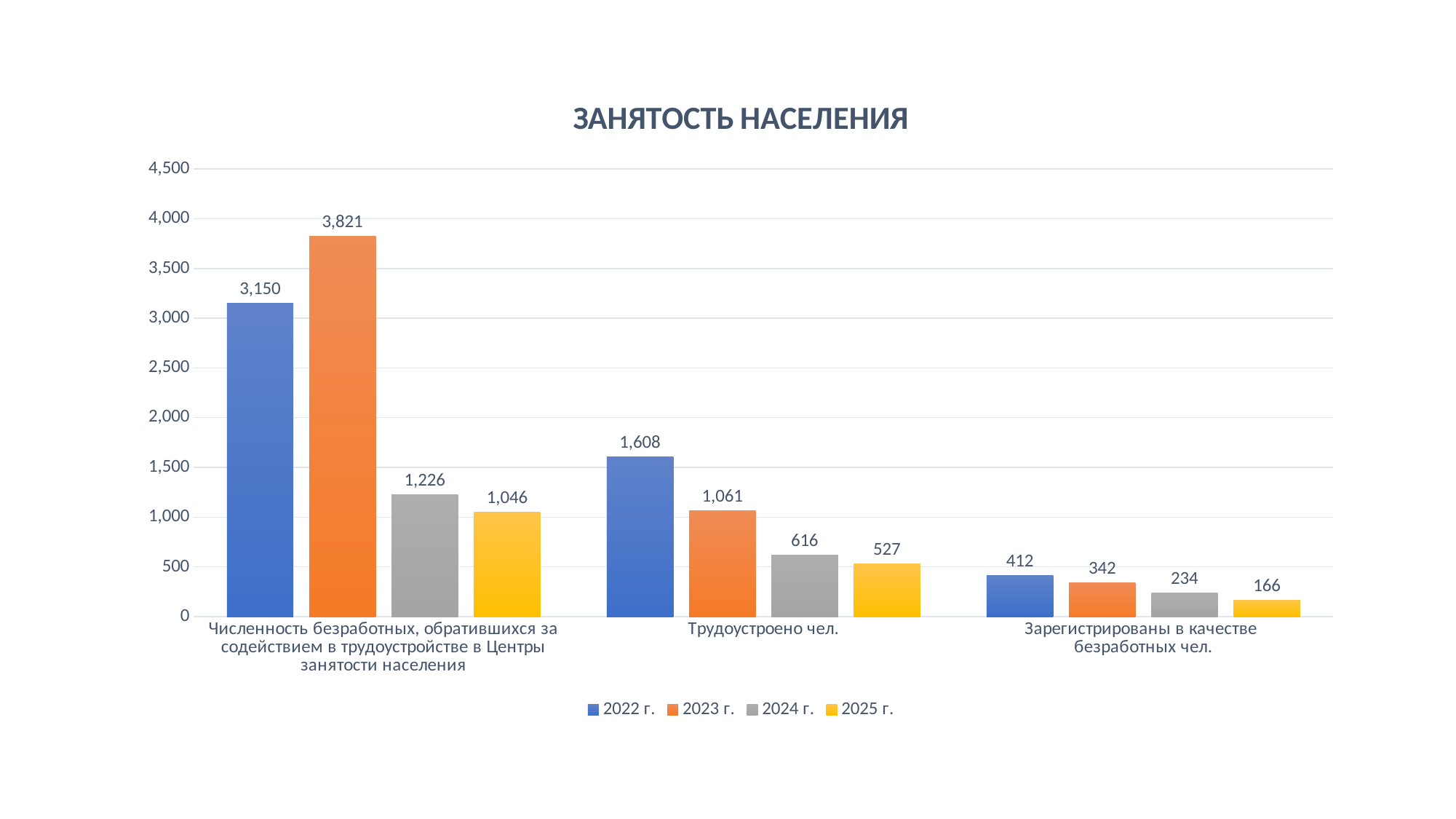
Which year has the lowest value in the category 'Численность безработных, обратившихся за содействием в трудоустройстве в Центры занятости населения'? 2025 г. Which year has the highest value in the category 'Трудоустроено чел.'? 2022 г. How many series does the legend list? 4 What is the value for 2025 г. in the category 'Зарегистрированы в качестве безработных чел.'? 166 Which is larger in the category 'Трудоустроено чел.': the value for 2023 г. or the value for 2024 г.? 2023 г. What kind of chart is shown on the slide? bar chart What is the title of the chart? ЗАНЯТОСТЬ НАСЕЛЕНИЯ Is the value for 2022 г. in the category 'Трудоустроено чел.' greater or less than 1,500? greater What is the difference between the 2022 г. and 2023 г. values in the category 'Зарегистрированы в качестве безработных чел.'? 70 How many categories are shown on the x axis? 3 What is the value for 2023 г. in the category 'Численность безработных, обратившихся за содействием в трудоустройстве в Центры занятости населения'? 3,821 What is the value for 2024 г. in the category 'Трудоустроено чел.'? 616